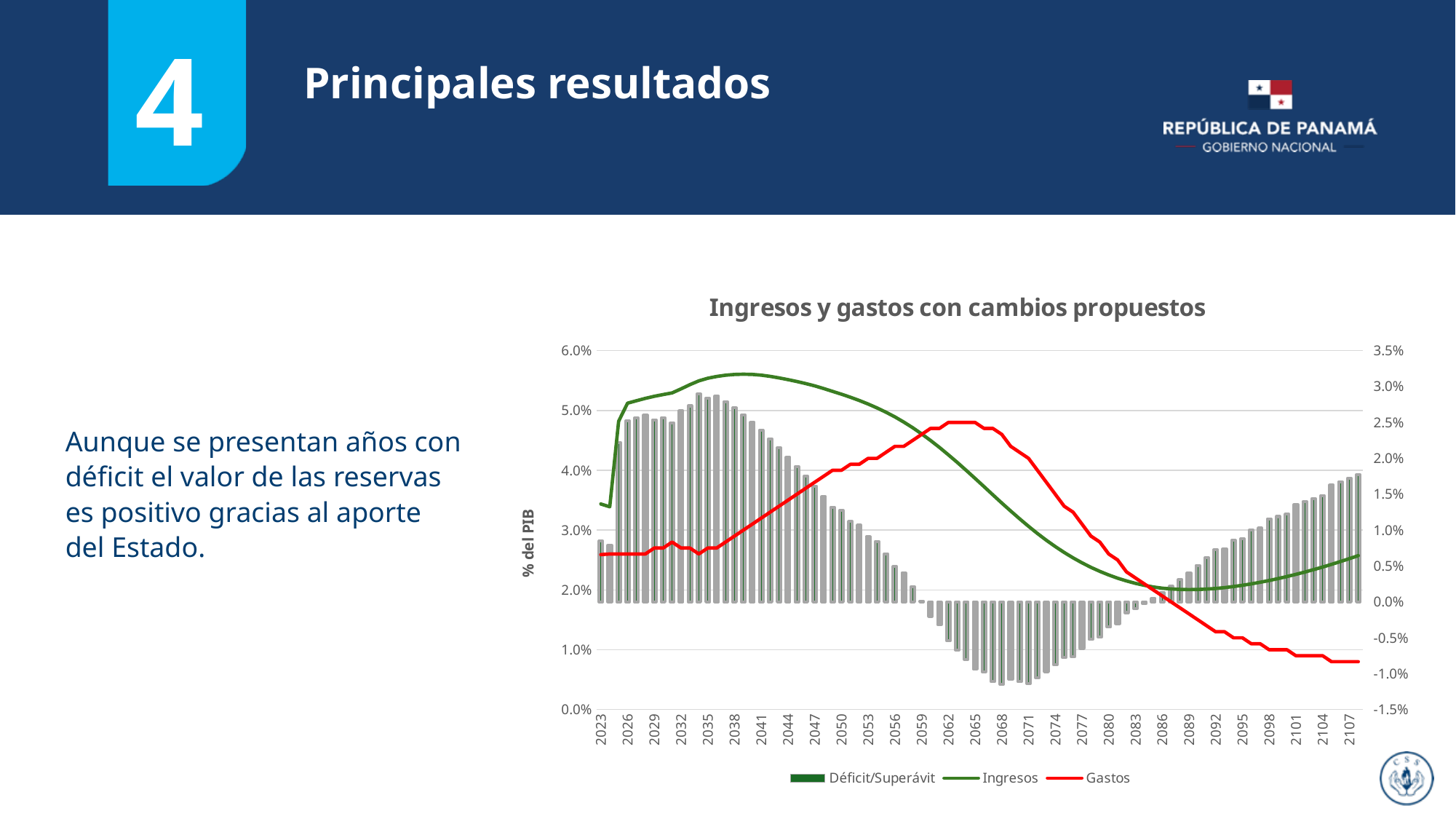
Is the value of Gastos in 2023 greater or less than 3.0% on the left axis? less What is the label of the left vertical axis? % del PIB What is the title of the chart? Ingresos y gastos con cambios propuestos How many series does the chart legend list? 3 Is the value of Gastos in 2062 greater or less than 4.0% on the left axis? greater Does the Ingresos line rise or fall between 2038 and 2080? fall Does the Gastos line rise or fall between 2065 and 2107? fall In 2065, which is higher, Ingresos or Gastos? Gastos Which series is drawn as a red line? Gastos Is the value of Ingresos in 2038 greater or less than 5.0% on the left axis? greater In 2038, which is higher, Ingresos or Gastos? Ingresos